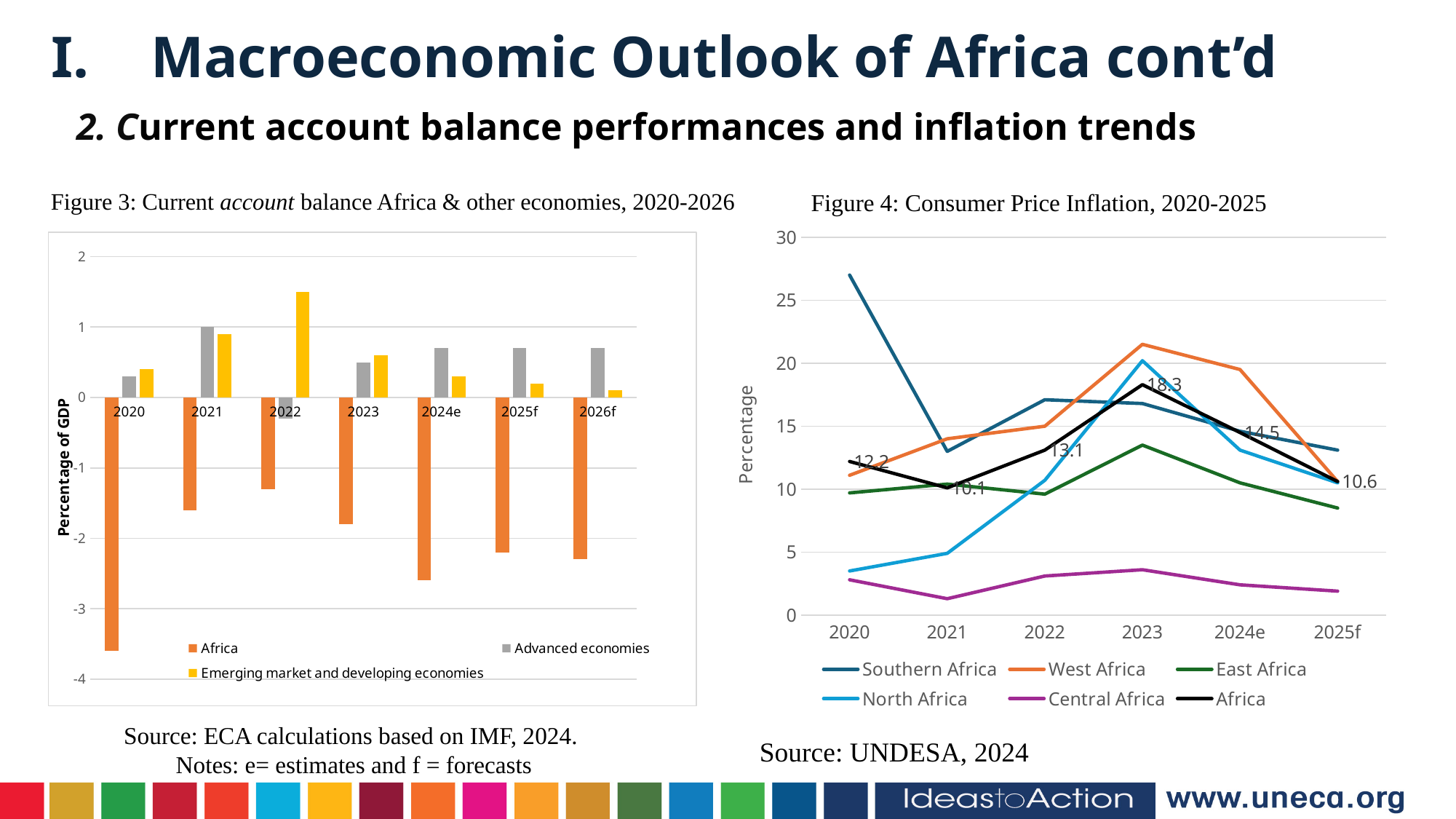
What kind of chart is Figure 3 (Current account balance)? bar chart In Figure 4 (Consumer Price Inflation), is the value for Southern Africa in 2020 greater or less than 25? greater In Figure 4 (Consumer Price Inflation), in which year does the Africa line have its lowest labelled value? 2021 In Figure 3 (Current account balance), in which year is the Africa bar lowest? 2020 How many series does the legend of Figure 3 (Current account balance) list? 3 In Figure 4 (Consumer Price Inflation), what is the difference between the Africa values for 2023 and 2024e? 3.8 In Figure 4 (Consumer Price Inflation), what is the labelled value for Africa in 2023? 18.3 In Figure 3 (Current account balance), is the value for Africa in 2020 greater or less than -3? less In Figure 4 (Consumer Price Inflation), in which year does the Africa line reach its highest labelled value? 2023 In Figure 4 (Consumer Price Inflation), what is the labelled value for Africa in 2020? 12.2 How many year categories are shown on the x axis of Figure 3 (Current account balance)? 7 How many series does the legend of Figure 4 (Consumer Price Inflation) list? 6